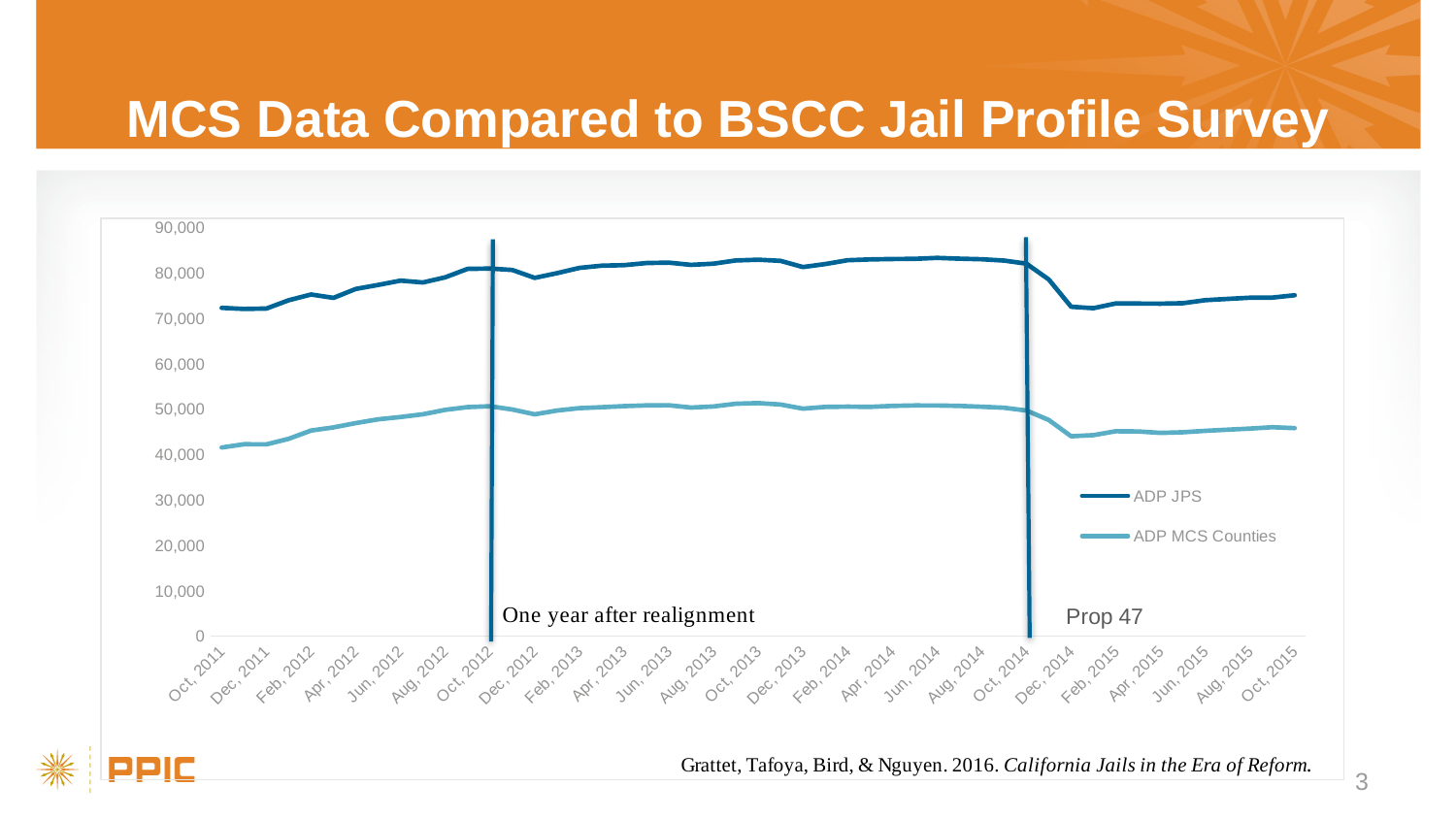
Which series has higher values throughout the chart, ADP JPS or ADP MCS Counties? ADP JPS Is the value for ADP MCS Counties at Oct, 2015 greater or less than 50,000? less Does the ADP MCS Counties series rise or fall between Oct, 2014 and Dec, 2014? fall Is the value for ADP MCS Counties at Oct, 2011 greater or less than 50,000? less What kind of chart is shown on the slide? Line chart What is the title of the slide containing the chart? MCS Data Compared to BSCC Jail Profile Survey Is the value for ADP JPS at Dec, 2014 greater or less than 80,000? less How many series does the legend list? 2 Does the ADP JPS series rise or fall between Oct, 2011 and Oct, 2012? rise What are the two series named in the legend? ADP JPS and ADP MCS Counties